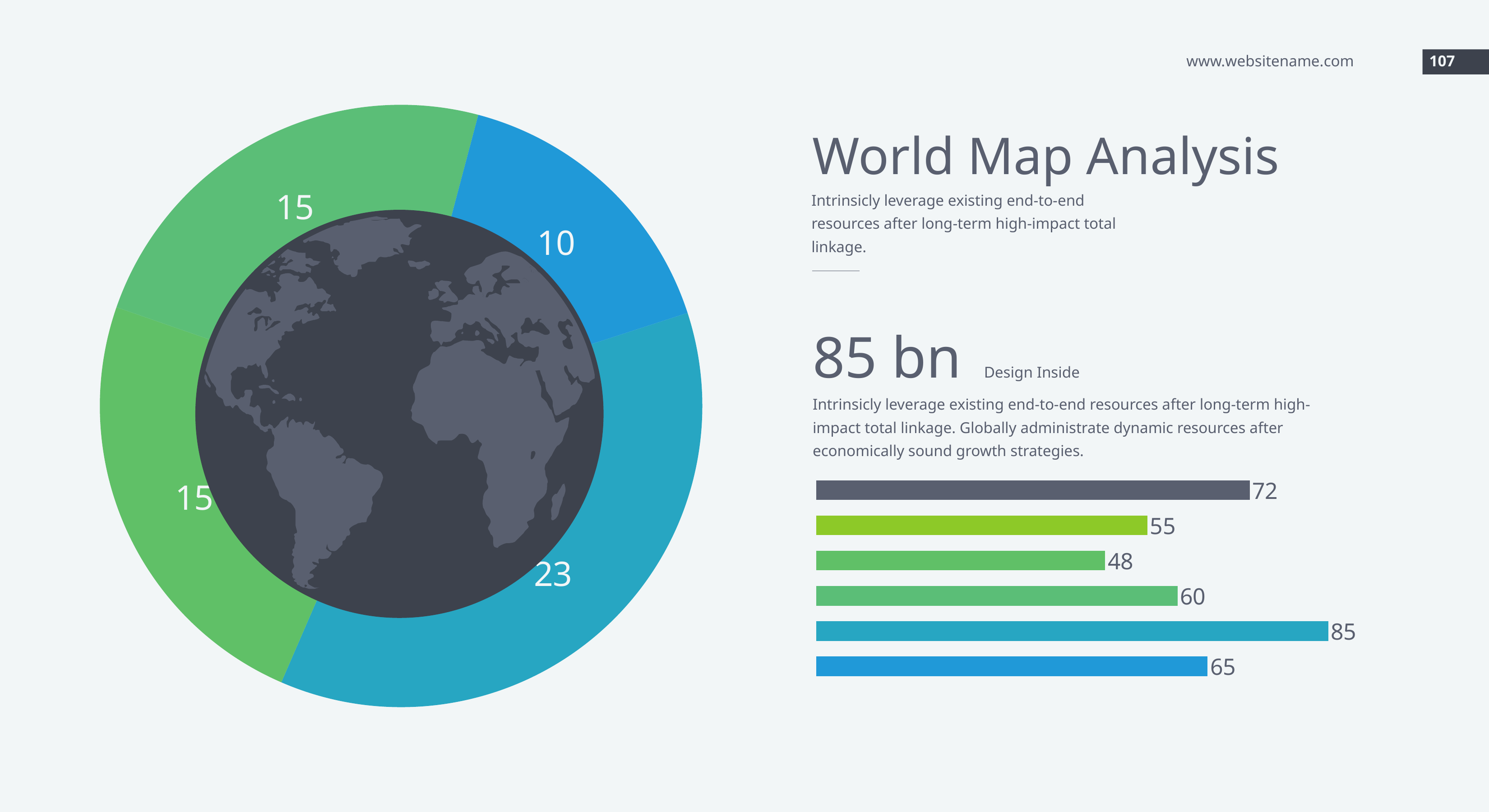
On the bar chart on the right, which is larger: the top bar or the bottom bar? the top bar (72) On the donut chart on the left, what is the value of the largest slice? 23 On the bar chart on the right, what is the value of the third bar from the top? 48 On the bar chart on the right, what is the value of the top bar? 72 On the bar chart on the right, what is the difference between the longest bar and the shortest bar? 37 On the bar chart on the right, what is the lowest value shown? 48 On the donut chart on the left, what is the value of the blue slice at the top right? 10 How many bars are in the bar chart on the right? 6 How many slices does the donut chart on the left have? 4 What kind of chart is shown on the right side of the slide? bar chart On the bar chart on the right, what is the value of the bottom bar? 65 On the bar chart on the right, what is the highest value shown? 85